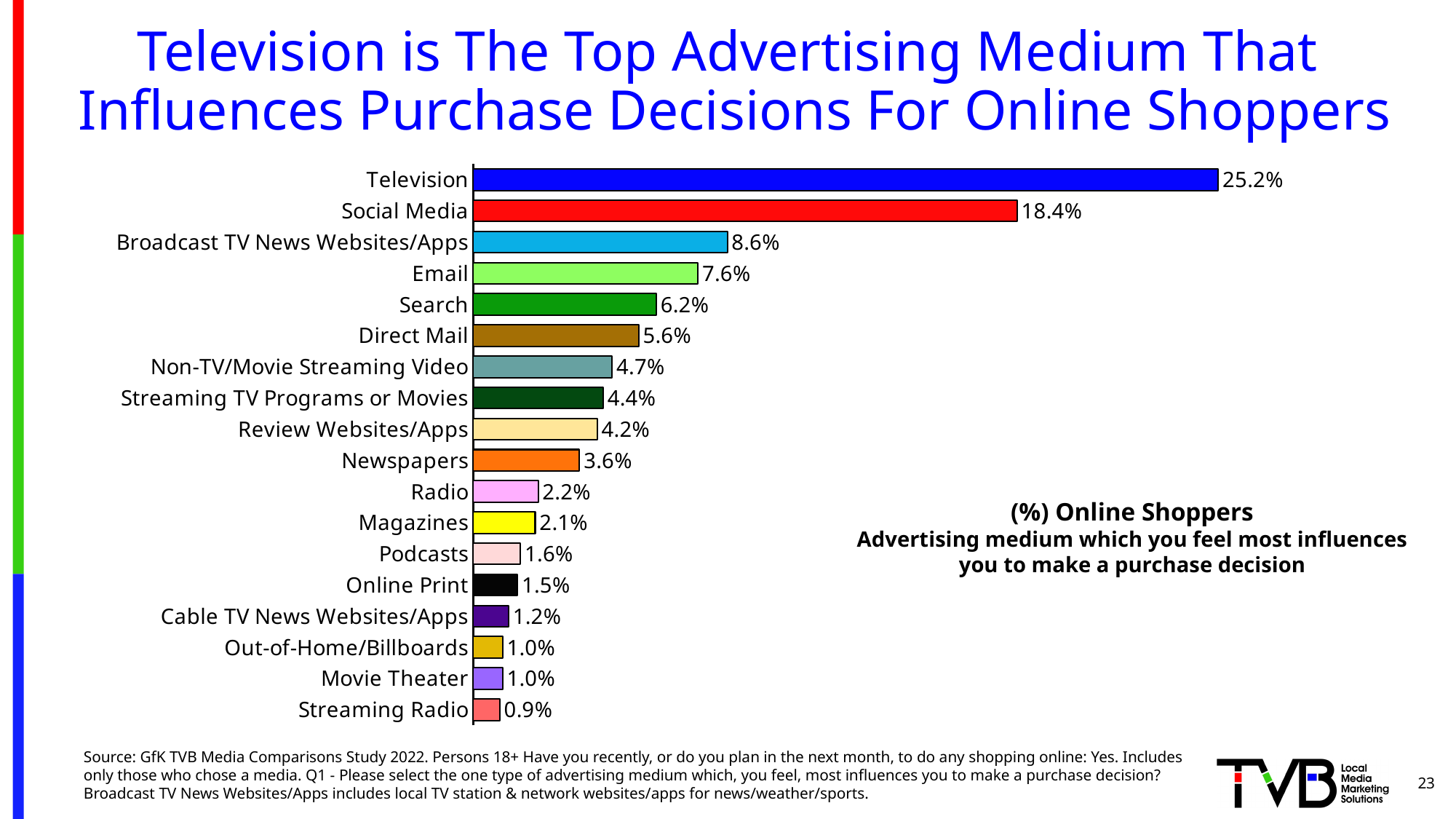
Which advertising medium has the lowest value in the chart? Streaming Radio What is the value shown for Podcasts? 1.6% What is the difference between the values for Email and Search? 1.4% Which has a larger value, Newspapers or Radio? Newspapers Which advertising medium has the highest value in the chart? Television What is the value shown for Direct Mail? 5.6% What type of chart is shown on the slide? Bar chart What is the difference between the values for Television and Social Media? 6.8% What is the value shown for Social Media? 18.4% What colour is the bar for Social Media? Red What percentage of online shoppers chose Television as the advertising medium that most influences their purchase decision? 25.2% How many advertising media categories are shown in the chart? 18